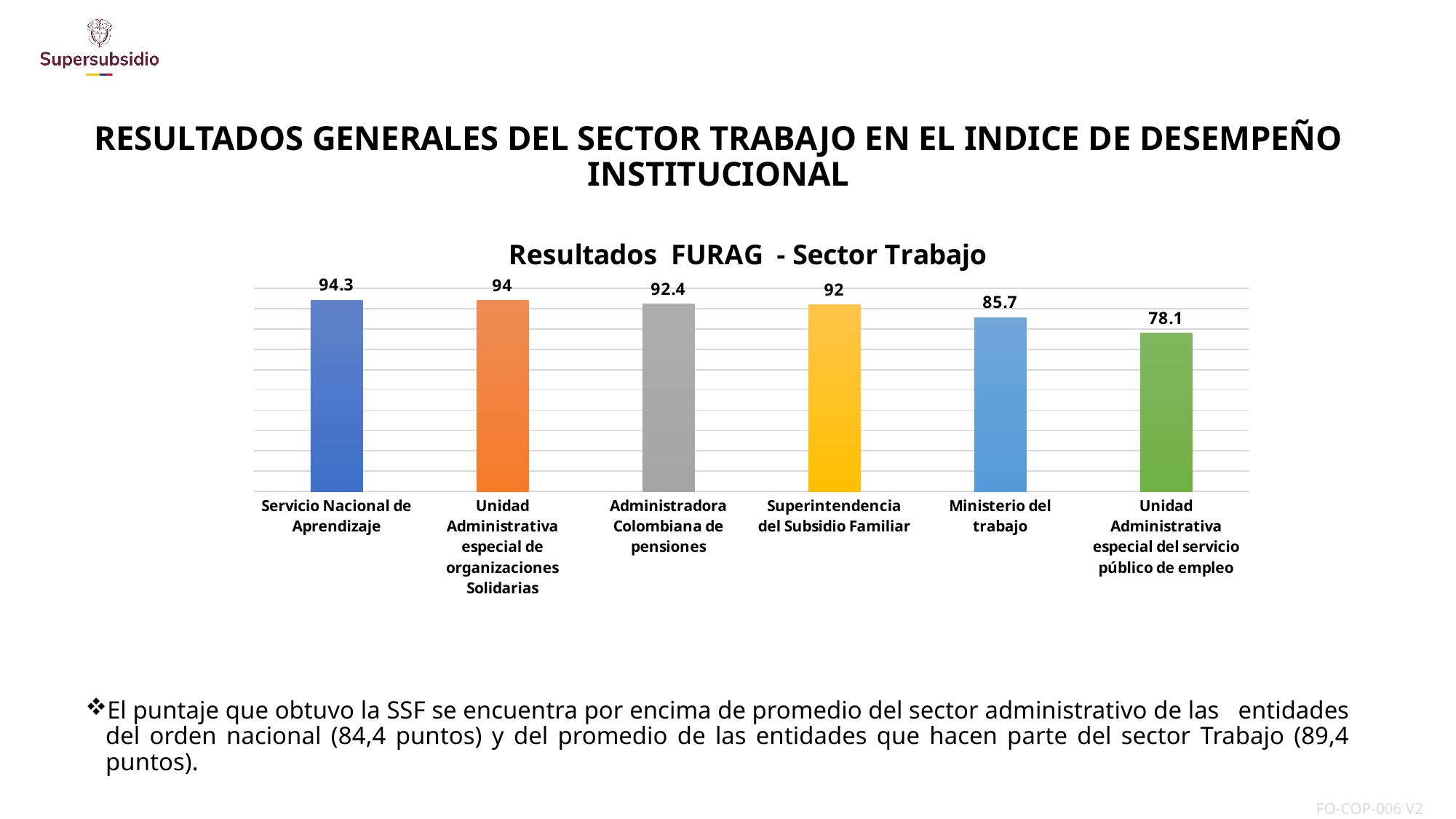
How many categories are shown in the chart? 6 What is the value for Superintendencia del Subsidio Familiar? 92 What is the title of the chart? Resultados FURAG - Sector Trabajo What kind of chart is shown on the slide? Bar chart What is the value for Ministerio del trabajo? 85.7 What is the value for Servicio Nacional de Aprendizaje? 94.3 What is the value for Unidad Administrativa especial del servicio público de empleo? 78.1 What is the difference between the values for Administradora Colombiana de pensiones and Ministerio del trabajo? 6.7 Which category has the lowest value? Unidad Administrativa especial del servicio público de empleo What is the difference between the values for Servicio Nacional de Aprendizaje and Unidad Administrativa especial del servicio público de empleo? 16.2 Which is larger, the value for Unidad Administrativa especial de organizaciones Solidarias or the value for Administradora Colombiana de pensiones? Unidad Administrativa especial de organizaciones Solidarias Which category has the highest value? Servicio Nacional de Aprendizaje